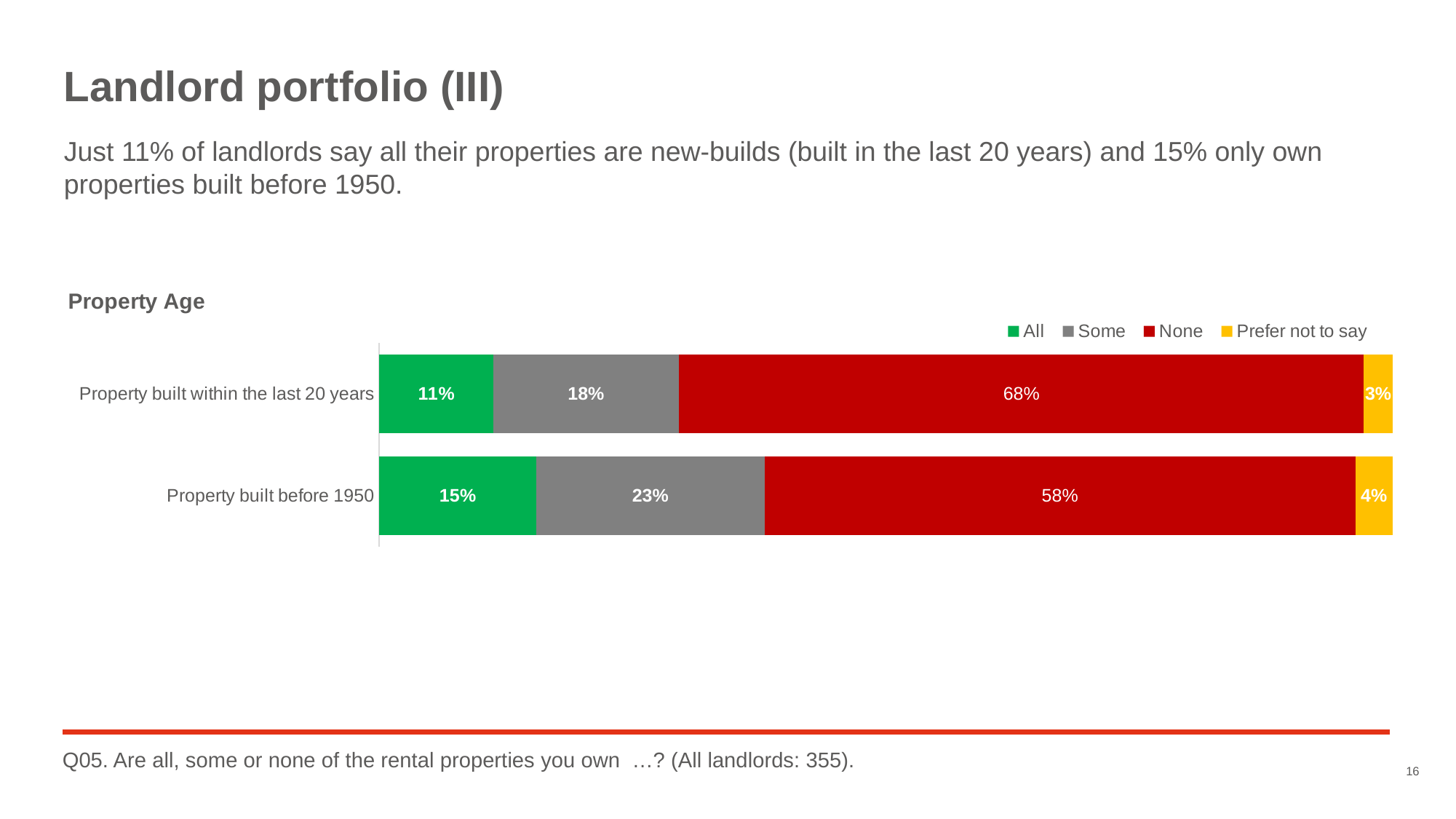
Is the 'All' value larger for 'Property built before 1950' or 'Property built within the last 20 years'? Property built before 1950 What percentage of landlords say all their properties were built within the last 20 years? 11% Which colour represents the 'None' series in the chart? Red What percentage of landlords say none of their properties were built before 1950? 58% What kind of chart is shown on the slide? Stacked bar chart How many series does the legend list? 4 Which category has the higher 'None' value? Property built within the last 20 years What is the difference between the 'None' values for the two categories? 10% What is the 'Some' value for 'Property built before 1950'? 23% What is the total of the stacked bar for 'Property built before 1950'? 100% What is the 'Prefer not to say' value for 'Property built within the last 20 years'? 3% How many categories are shown in the chart? 2